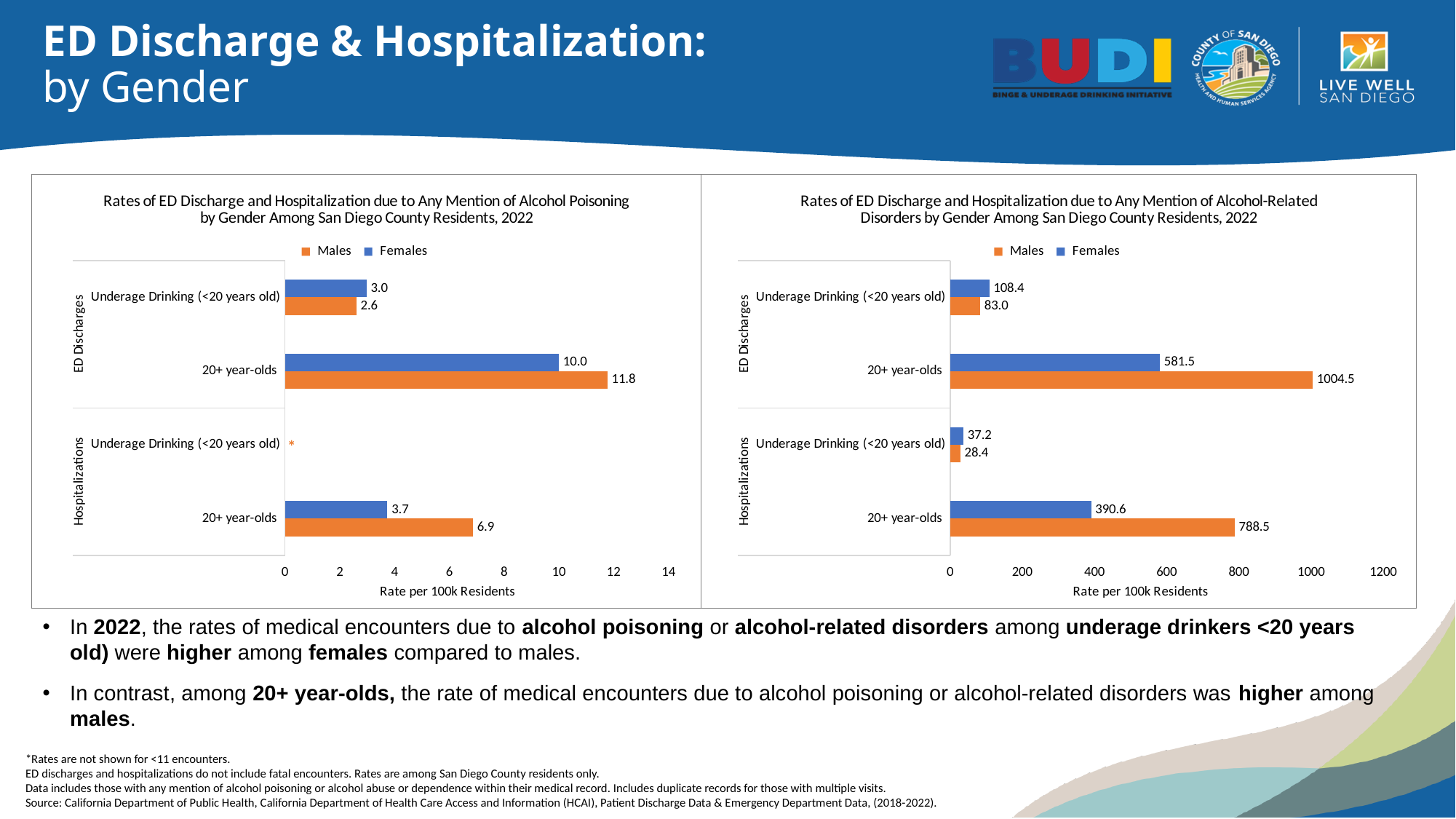
In the right chart (Alcohol-Related Disorders), what is the hospitalization rate for males aged 20+ year-olds? 788.5 In the right chart (Alcohol-Related Disorders), what is the difference between the male and female ED discharge rates for 20+ year-olds? 423.0 What type of chart is the right chart (Alcohol-Related Disorders)? Bar chart In the left chart (Alcohol Poisoning), which is larger for Underage Drinking (<20 years old) ED discharges: the male rate or the female rate? Female rate In the right chart (Alcohol-Related Disorders), what is the ED discharge rate for females in the Underage Drinking (<20 years old) group? 108.4 In the left chart (Alcohol Poisoning), what does the asterisk next to Underage Drinking (<20 years old) hospitalizations indicate? Rates are not shown for <11 encounters In the left chart (Alcohol Poisoning), what is the difference between the male and female hospitalization rates for 20+ year-olds? 3.2 In the right chart (Alcohol-Related Disorders), which bar has the highest value? Males, 20+ year-olds, ED Discharges (1004.5) How many series does the legend list in the left chart (Alcohol Poisoning)? 2 In the left chart (Alcohol Poisoning), what is the ED discharge rate for males aged 20+ year-olds? 11.8 In the left chart (Alcohol Poisoning), what is the ED discharge rate for females in the Underage Drinking (<20 years old) group? 3.0 In the right chart (Alcohol-Related Disorders), is the female hospitalization rate for 20+ year-olds greater or less than 400? less